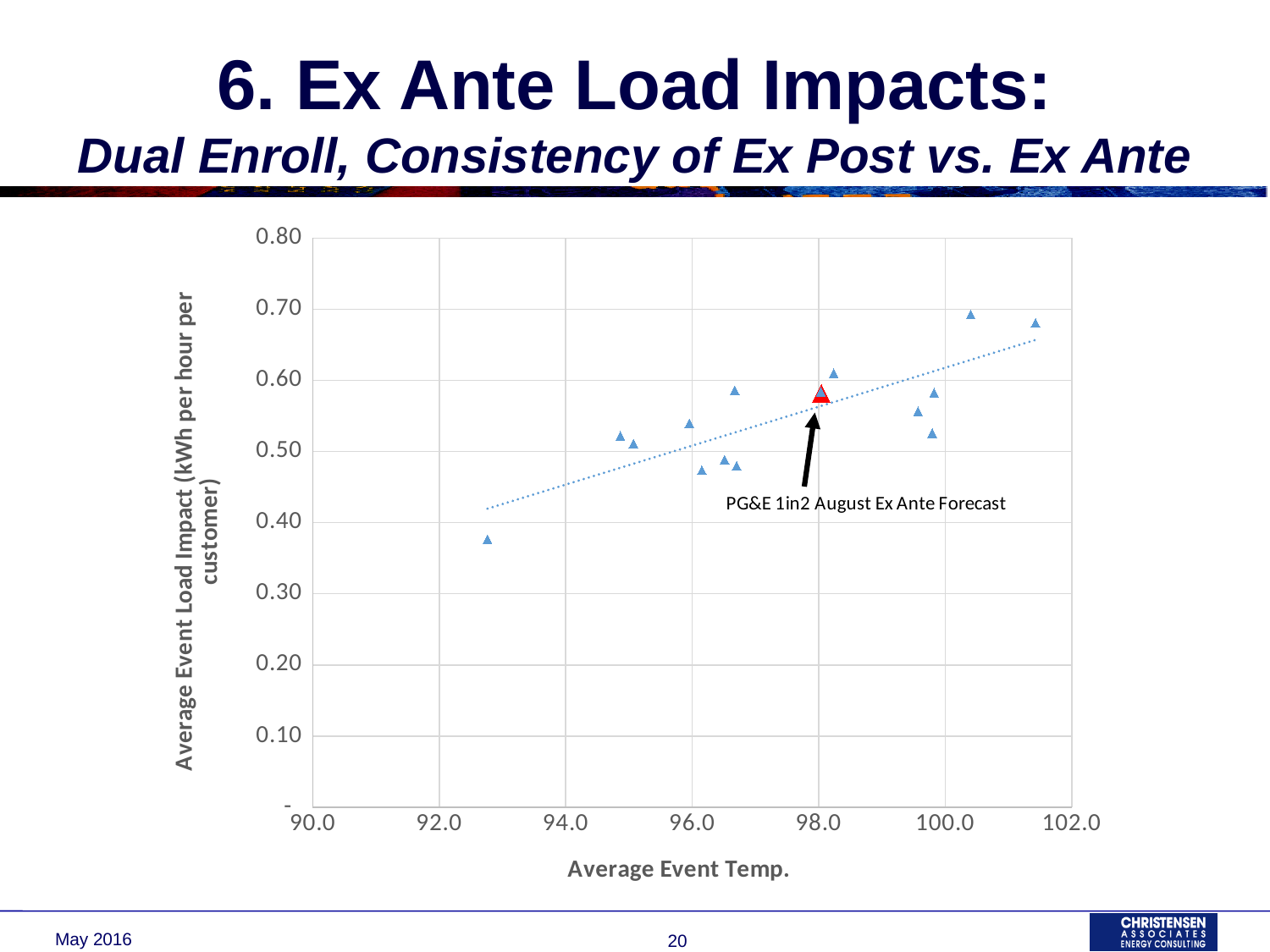
Do the plotted load impact values generally rise or fall as average event temperature increases? Rise What is the maximum value shown on the y axis? 0.80 Is the value of the red triangle labelled 'PG&E 1in2 August Ex Ante Forecast' greater or less than 0.50? greater Is the value of the point plotted near 96.2 on the x axis greater or less than 0.50? less Is the red triangle's load impact greater or less than 0.70? less Which point has the lowest load impact: the one near 92.8 or the one near 96.2 on the x axis? The one near 92.8 What is the label of the x axis? Average Event Temp. What is the label of the y axis? Average Event Load Impact (kWh per hour per customer) What kind of chart is shown on the slide? Scatter chart